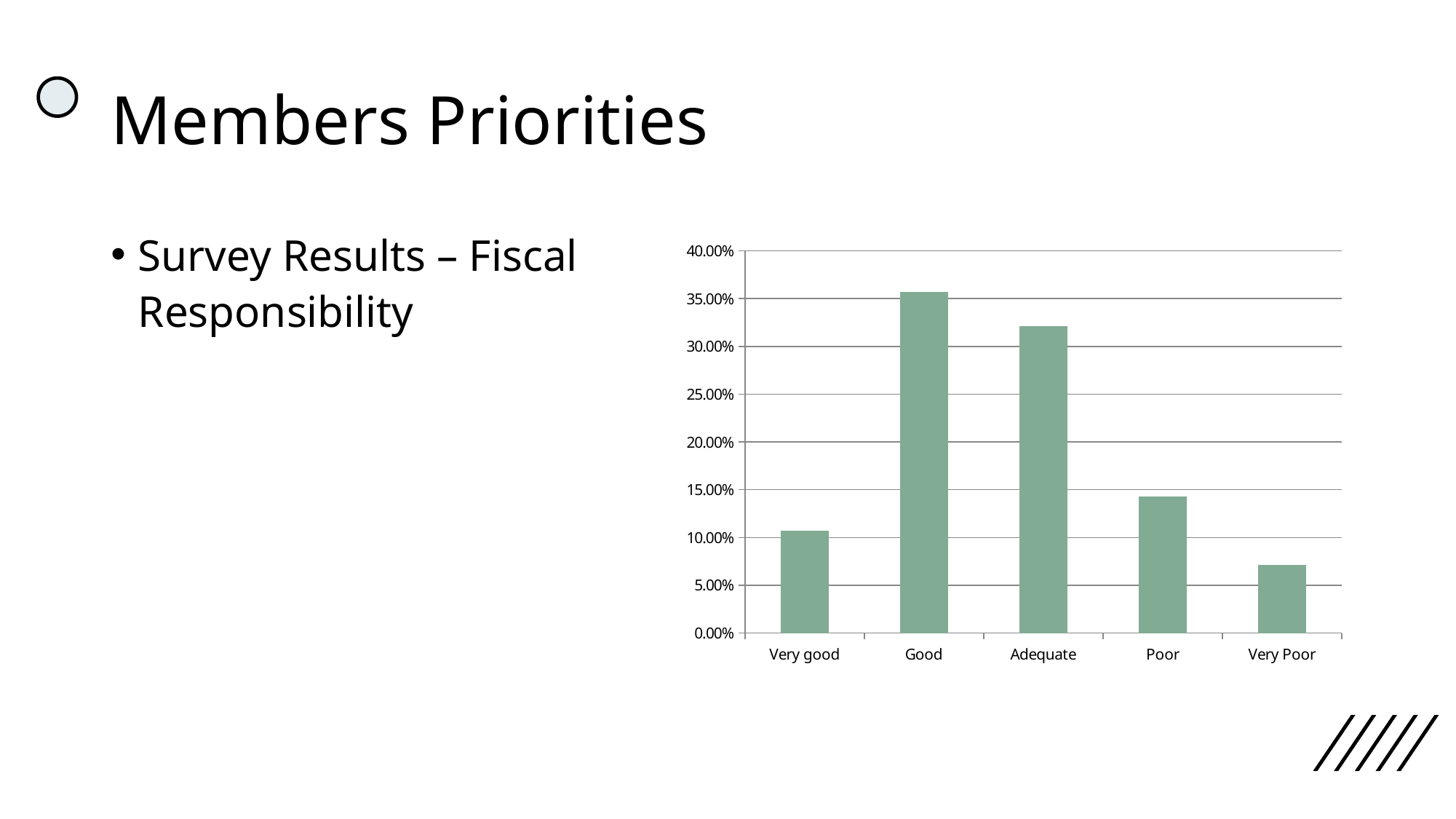
Is the value for Adequate greater or less than 30.00%? greater How many categories are shown on the x axis of the chart? 5 Is the value for Very good greater or less than 15.00%? less Is the value for Very Poor greater or less than 10.00%? less Which is larger, the value for Good or the value for Adequate? Good Which is larger, the value for Very good or the value for Poor? Poor Which category has the highest bar in the chart? Good Do the values rise or fall along the x axis from Adequate to Very Poor? fall What is the highest value shown on the chart's y axis? 40.00% Which category has the lowest bar in the chart? Very Poor What kind of chart is shown on the slide? Bar chart